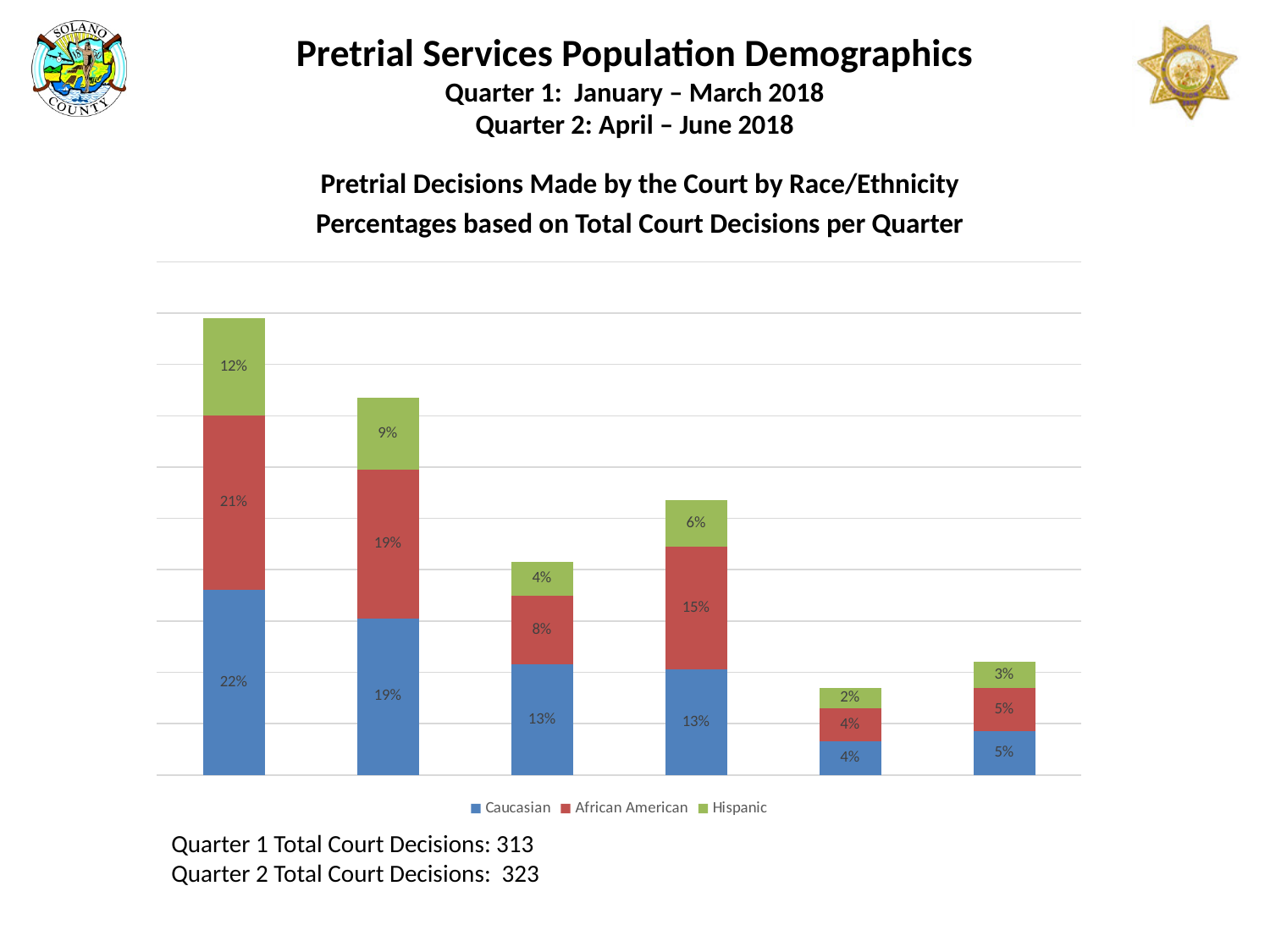
How many series does the chart legend list? 3 Which bar is the shortest overall? the fifth bar from the left What is the total of the first (leftmost) stacked bar? 55% What is the total of the fifth bar from the left? 10% What kind of chart is shown on the slide? stacked bar chart What is the Caucasian value shown on the fourth bar from the left? 13% Which bar is the tallest overall? the first (leftmost) bar What is the difference between the African American value on the first bar and the African American value on the third bar? 13% What is the African American value shown on the second bar from the left? 19% How many stacked bars are plotted in the chart? 6 What is the Hispanic value shown on the first (leftmost) bar? 12% Which series is listed first in the chart legend? Caucasian